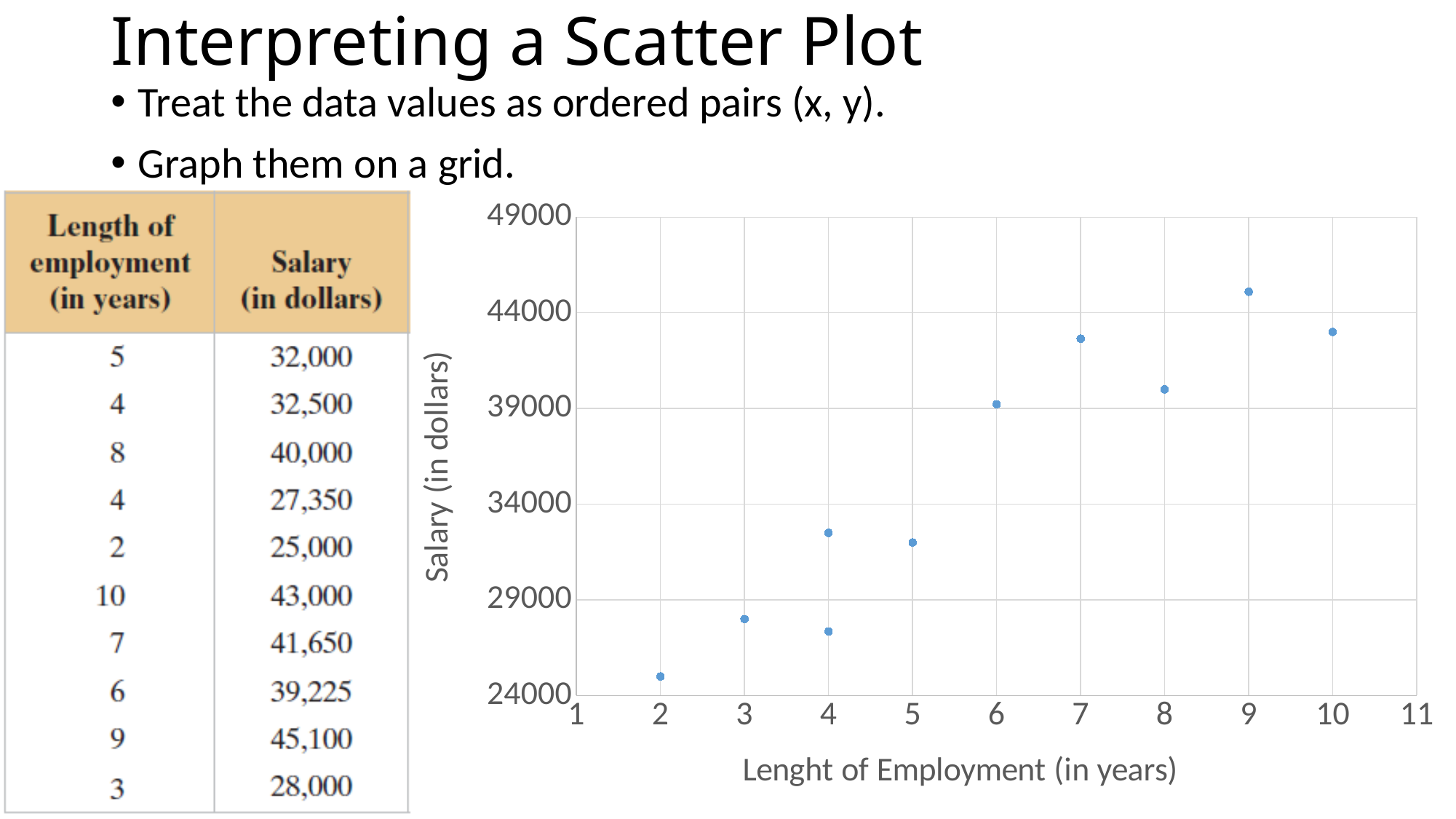
According to the table, what is the salary for 10 years of employment? 43,000 What kind of chart is shown on the slide? Scatter plot How many data points are plotted on the scatter plot? 10 Which length of employment has the highest salary? 9 years What is the title of the y axis of the scatter plot? Salary (in dollars) Is the salary for 3 years of employment greater or less than 29000? less Which length of employment has the lowest salary? 2 years What is the title of the x axis of the scatter plot? Lenght of Employment (in years) Is the salary for 7 years of employment greater or less than 39000? greater Do salaries generally rise or fall as length of employment increases along the x axis? Rise According to the table, what is the salary for 6 years of employment? 39,225 Using the table values, what is the difference between the salary for 9 years and the salary for 10 years of employment? 2,100